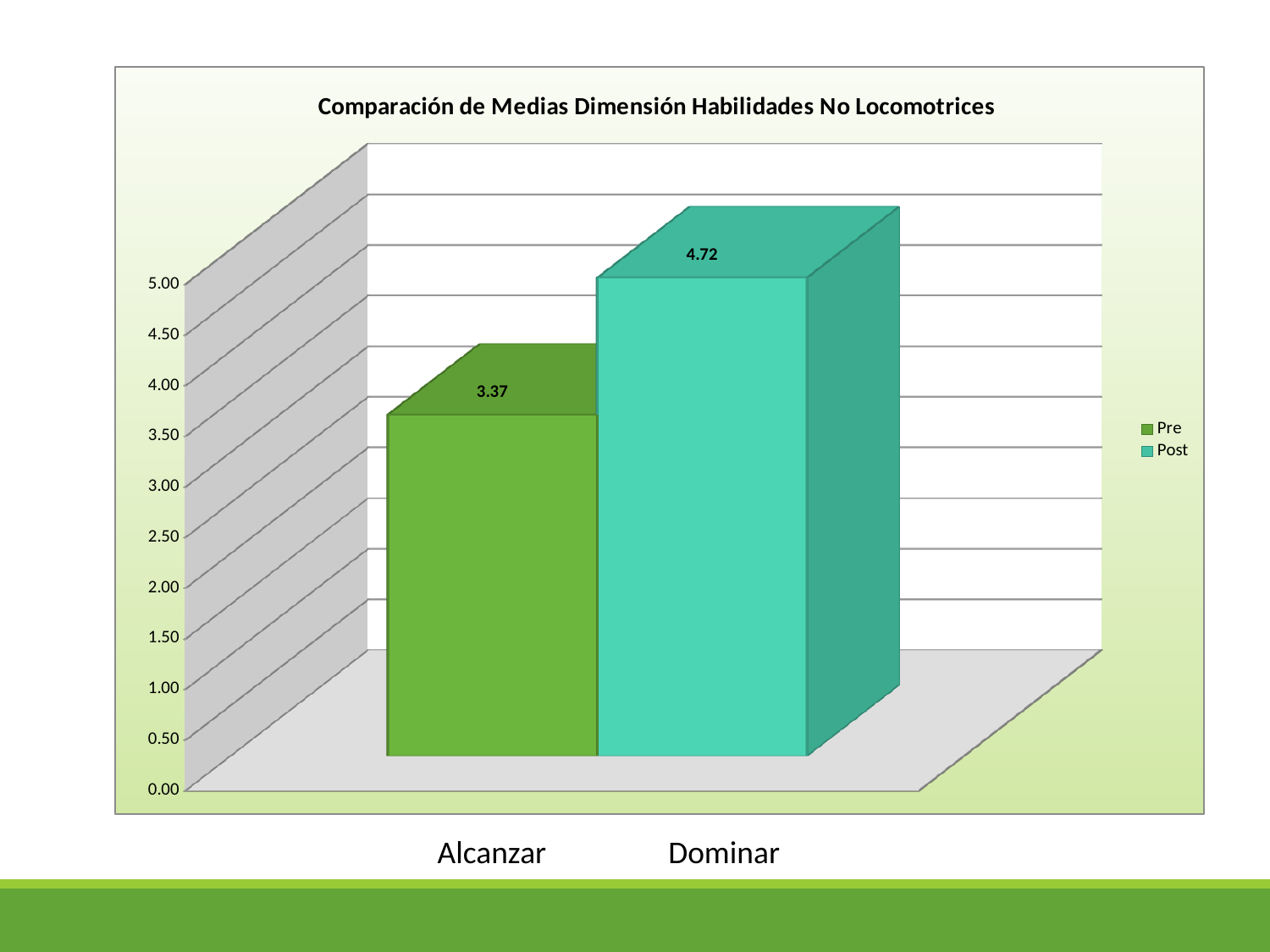
Which series has the higher value, Pre or Post? Post What kind of chart is shown on the slide? Bar chart What is the value of the Pre bar? 3.37 Which bar is the highest in the chart? Post What is the title of the chart? Comparación de Medias Dimensión Habilidades No Locomotrices How many series does the legend list? 2 Which bar is the lowest in the chart? Pre Is the value of the Pre bar greater or less than 4.00? less What is the value of the Post bar? 4.72 What is the difference between the Post value and the Pre value? 1.35 How many bars are plotted in the chart? 2 Is the value of the Post bar greater or less than 4.50? greater